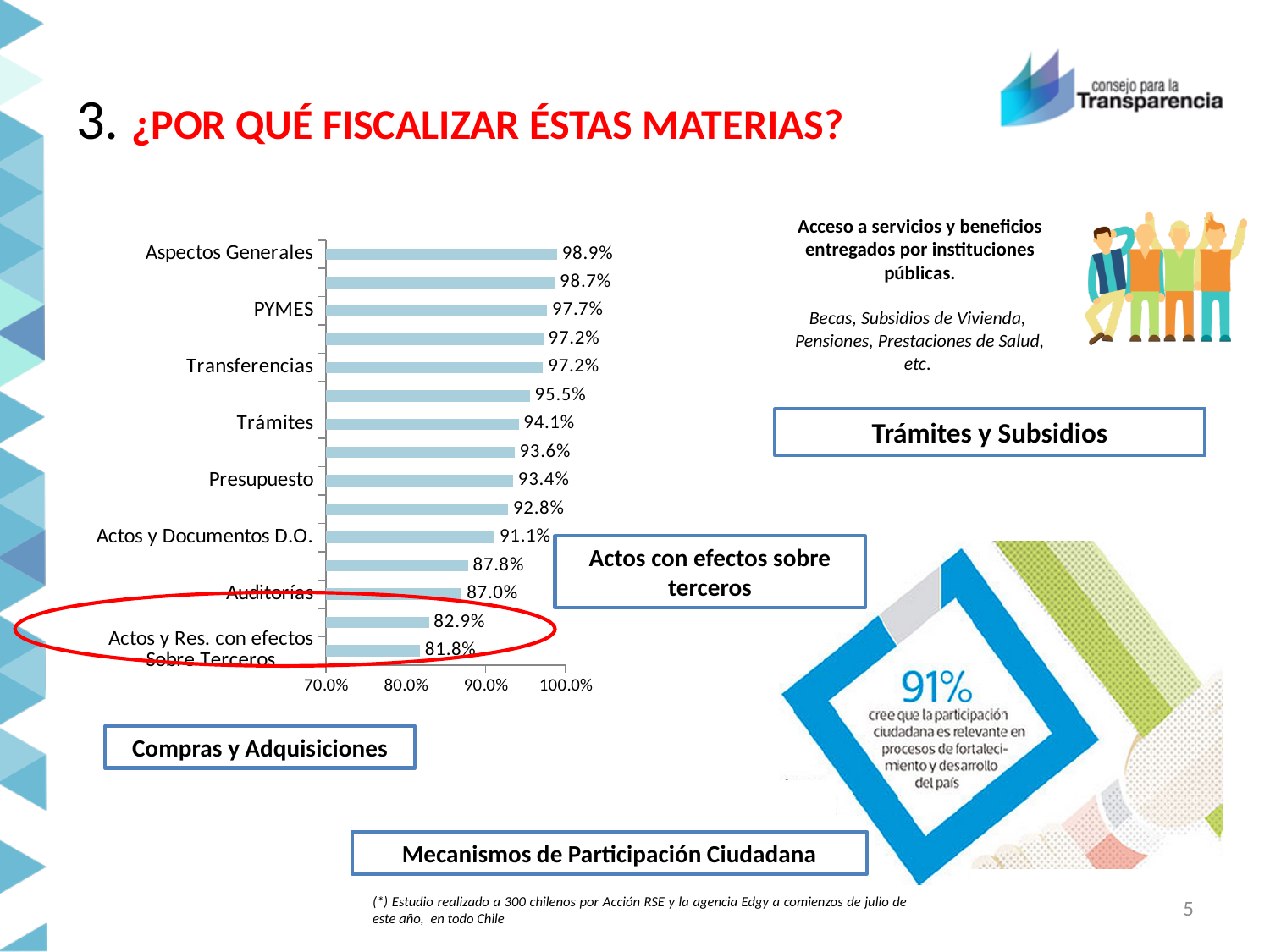
Which labeled category has the lowest value in the chart? Actos y Res. con efectos Sobre Terceros What is the value shown for Actos y Res. con efectos Sobre Terceros? 81.8% What is the value shown for Trámites? 94.1% What is the value shown for Aspectos Generales? 98.9% What is the difference between the values for Aspectos Generales and Presupuesto? 5.5% What is the value shown for PYMES? 97.7% What is the value shown for Auditorías? 87.0% How many bars are plotted in the chart? 15 What type of chart is shown on the slide? Bar chart Which is larger, the value for Transferencias or the value for Actos y Documentos D.O.? Transferencias Which labeled category has the highest value in the chart? Aspectos Generales Is the value for Auditorías greater or less than 90.0%? less